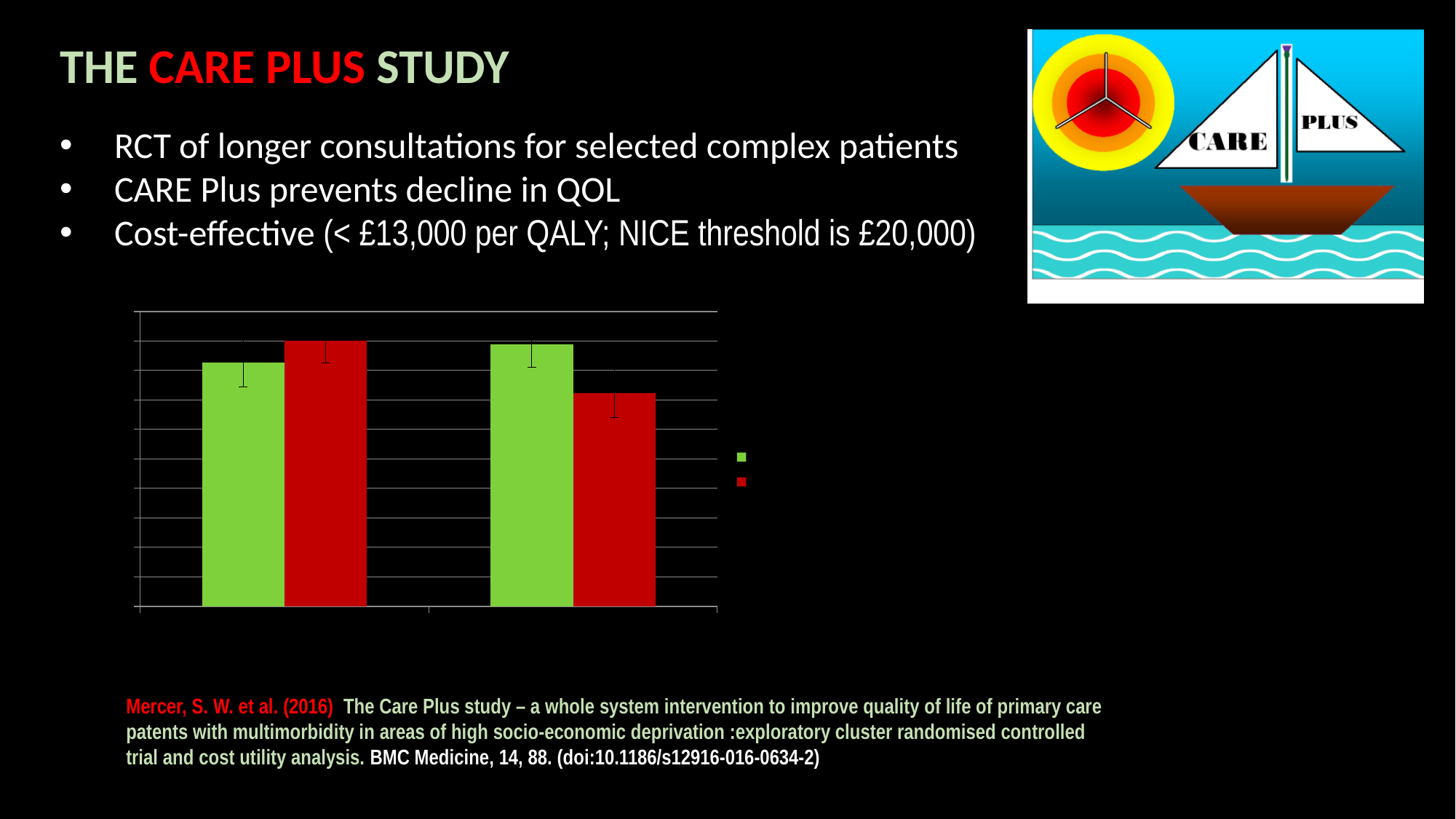
Do the bars in the chart have error bars? yes In the right group of bars, which bar is taller, the green one or the red one? the green one Does the green series rise or fall from the left group to the right group? rise Does the red series rise or fall from the left group to the right group? fall Which single bar in the chart is the lowest? the red bar in the right group What kind of chart is shown on the slide? bar chart What two colours are used for the bars in the chart? green and red How many series does the chart's legend list? 2 In the left group of bars, which bar is taller, the green one or the red one? the red one How many groups of bars are plotted along the x axis of the chart? 2